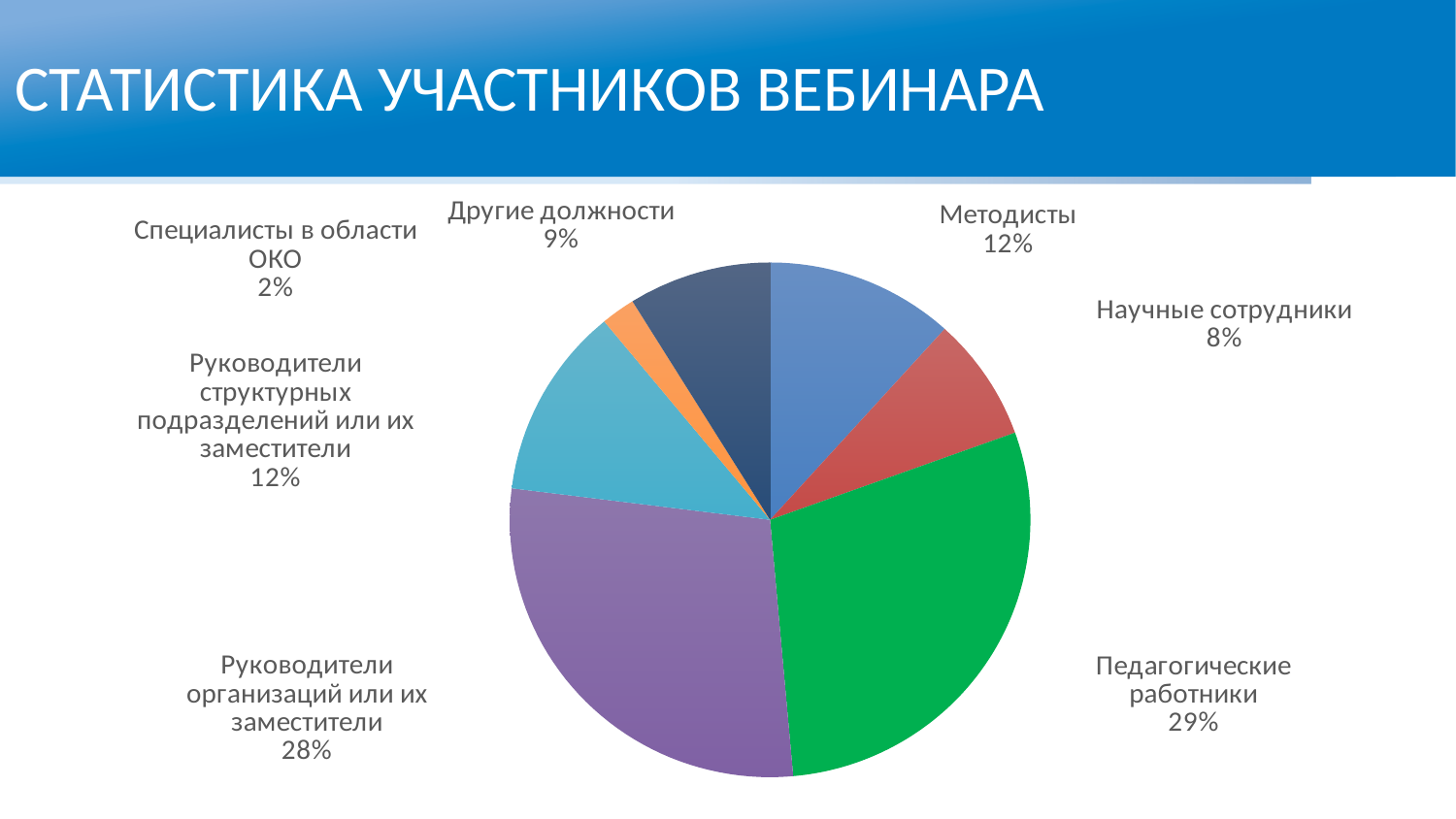
Which category has the largest share of the pie? Педагогические работники Which is larger: the share of Методисты or the share of Другие должности? Методисты What percentage of participants are Руководители организаций или их заместители? 28% What type of chart is shown on the slide? Pie chart What percentage of participants are Методисты? 12% Which category has the smallest share of the pie? Специалисты в области ОКО What is the difference in percentage points between Педагогические работники and Научные сотрудники? 21 What share of webinar participants are Педагогические работники? 29% How many categories are shown in the pie chart? 7 What percentage of participants are Научные сотрудники? 8% What is the title of the slide? СТАТИСТИКА УЧАСТНИКОВ ВЕБИНАРА What share is labelled Другие должности? 9%